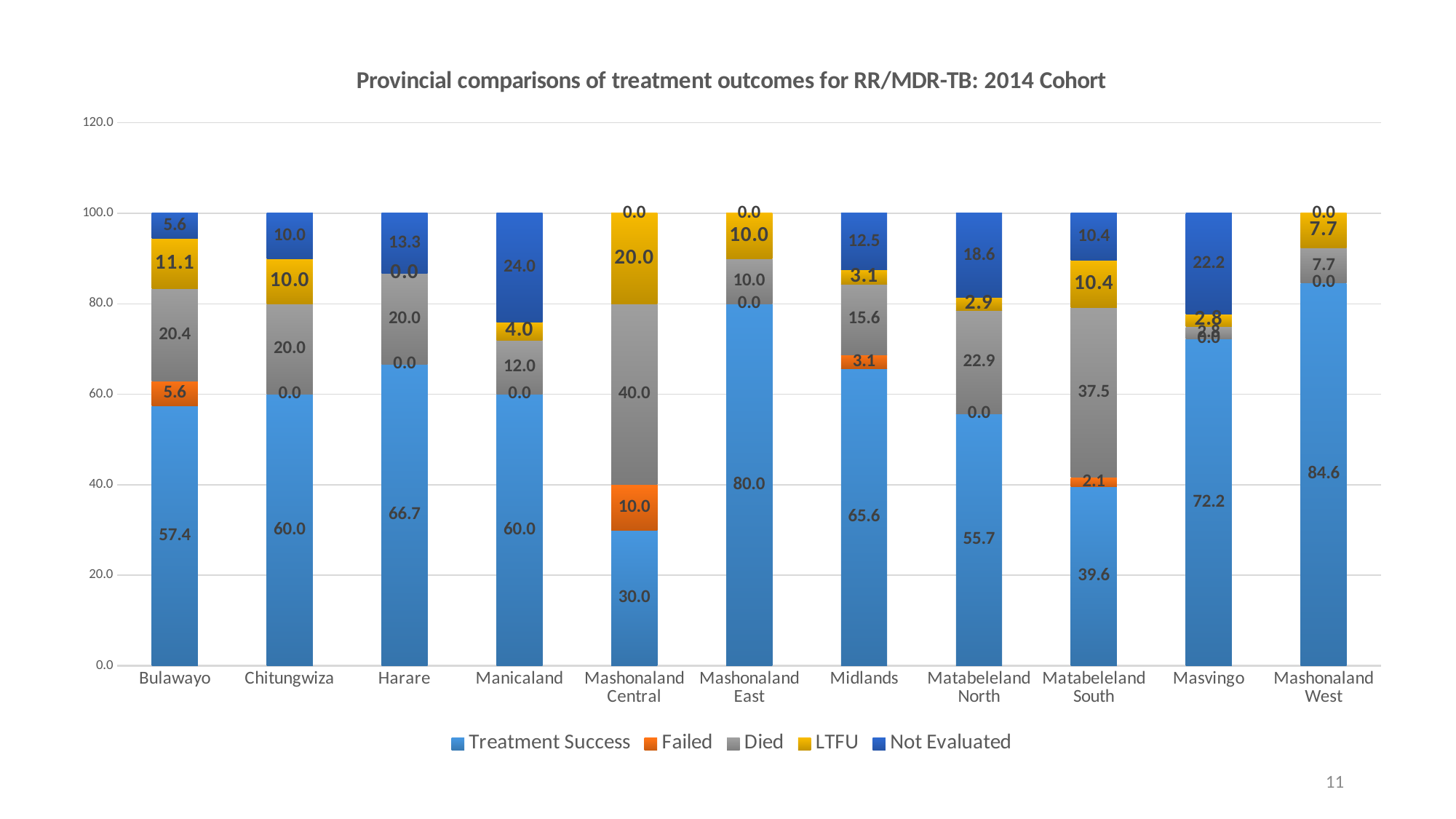
What is the Died value for Mashonaland Central? 40.0 Which province has the highest Treatment Success value? Mashonaland West How many series does the legend list? 5 Which has the larger Died value, Matabeleland South or Bulawayo? Matabeleland South What is the Not Evaluated value for Manicaland? 24.0 What is the Failed value for Mashonaland Central? 10.0 Which province has the lowest Treatment Success value? Mashonaland Central What is the difference between the Treatment Success values for Mashonaland East and Mashonaland Central? 50.0 How many provinces are shown on the x axis? 11 What kind of chart is shown on the slide? Stacked bar chart What is the title of the chart? Provincial comparisons of treatment outcomes for RR/MDR-TB: 2014 Cohort What is the Treatment Success value for Mashonaland West? 84.6